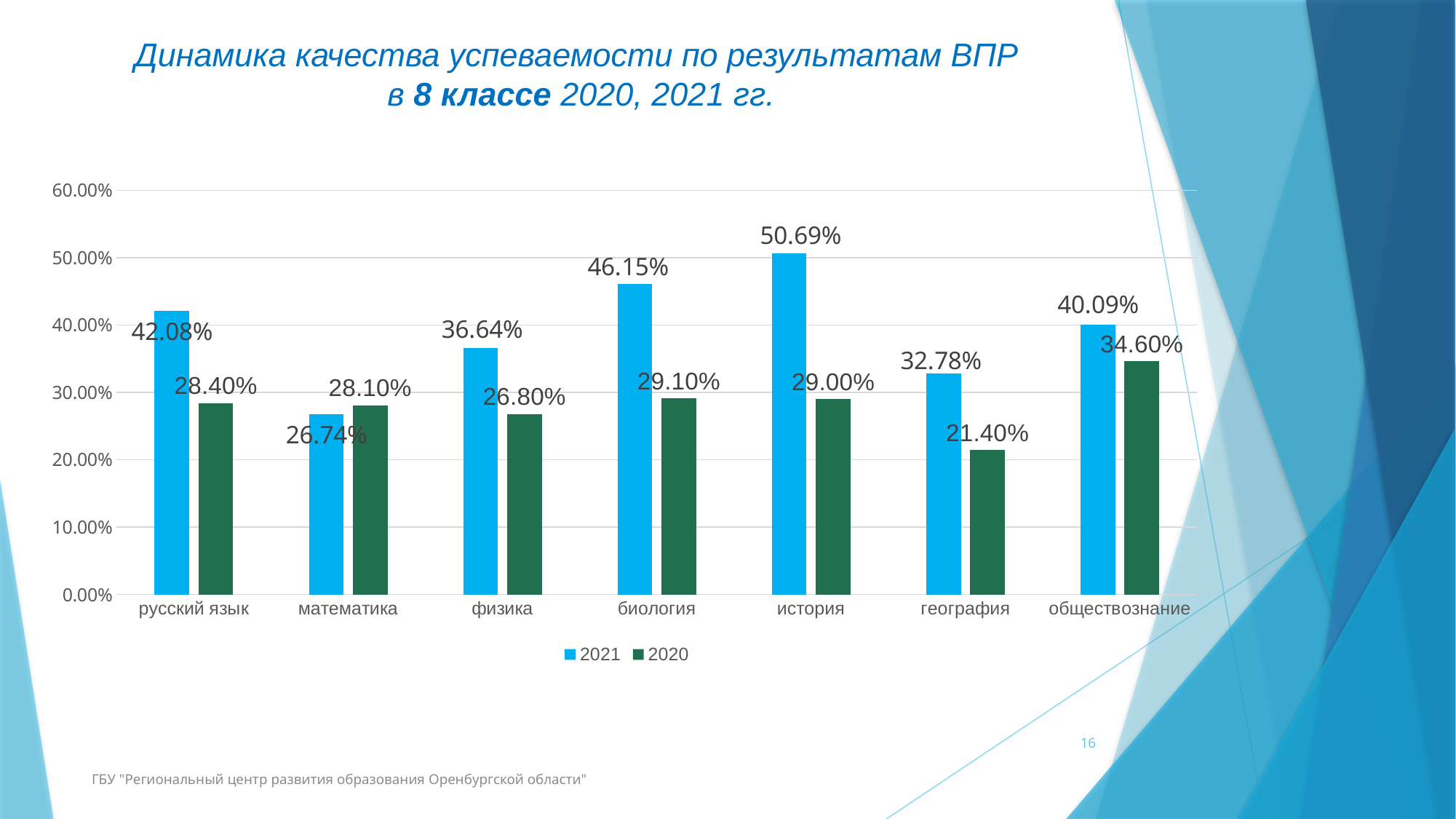
What is the 2020 value for география? 21.40% Which subject has the highest 2021 value? история What is the 2021 value for физика? 36.64% Which subject has the lowest 2020 value? география What is the 2021 value for история? 50.69% What is the difference between the 2021 and 2020 values for русский язык? 13.68% Which is larger for математика, the 2021 value or the 2020 value? 2020 How many subjects are shown on the x axis? 7 Which colour represents the 2020 series in the legend? dark green What kind of chart is shown on the slide? bar chart How many series does the legend list? 2 Which subject has the lowest 2021 value? математика